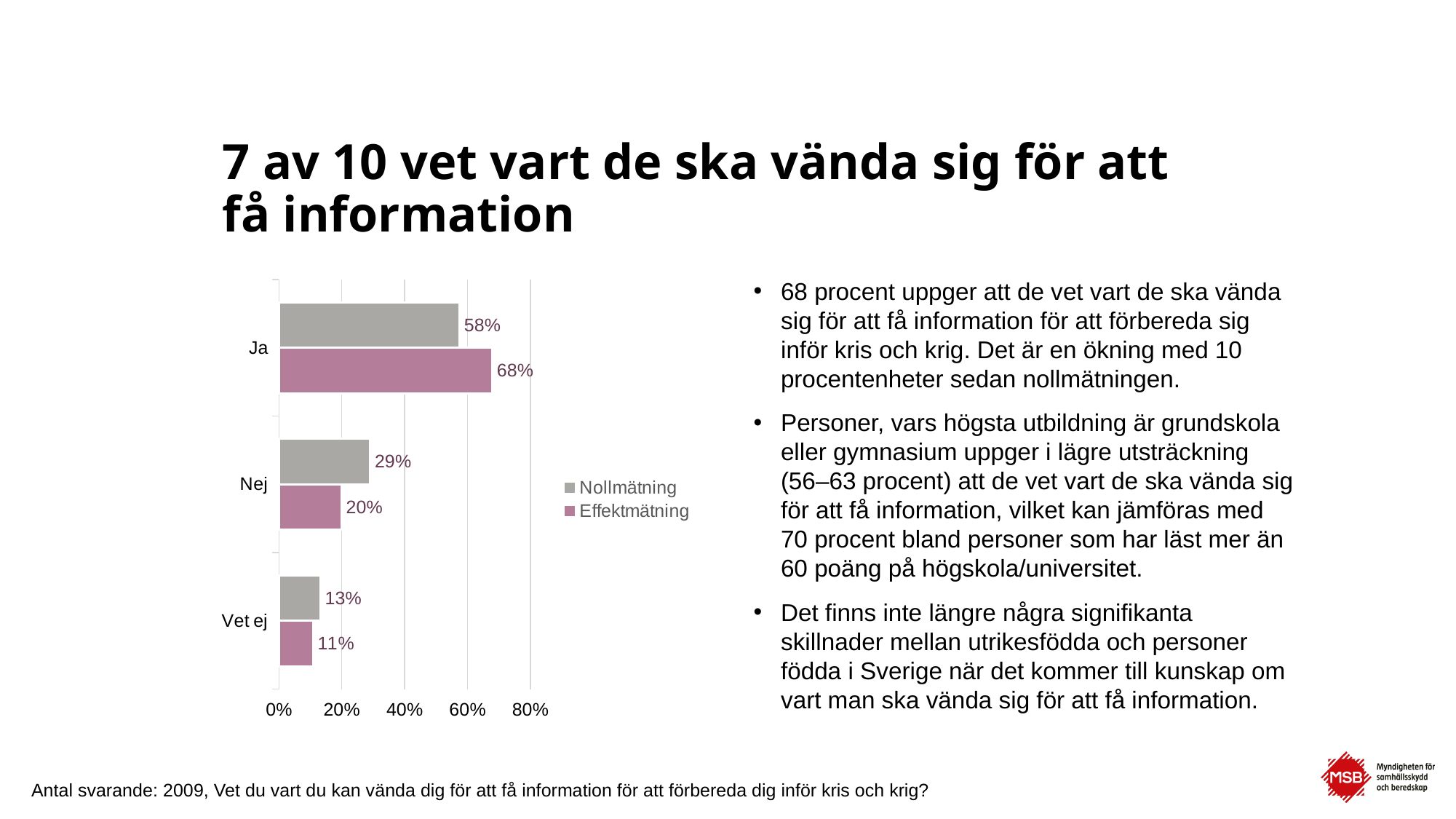
What is the difference between the Nollmätning and Effektmätning values for Nej? 9 percentage points How many series does the legend list? 2 What is the Nollmätning value for Nej? 29% How many categories are shown on the chart? 3 What is the difference between the Effektmätning and Nollmätning values for Ja? 10 percentage points Which series is shown in pink/purple in the legend? Effektmätning Which category has the lowest Effektmätning value? Vet ej What is the Effektmätning value for Vet ej? 11% What kind of chart is shown on the slide? Bar chart What is the Effektmätning value for Ja? 68% Which is larger for Vet ej: the Nollmätning value or the Effektmätning value? Nollmätning Which category has the highest Nollmätning value? Ja